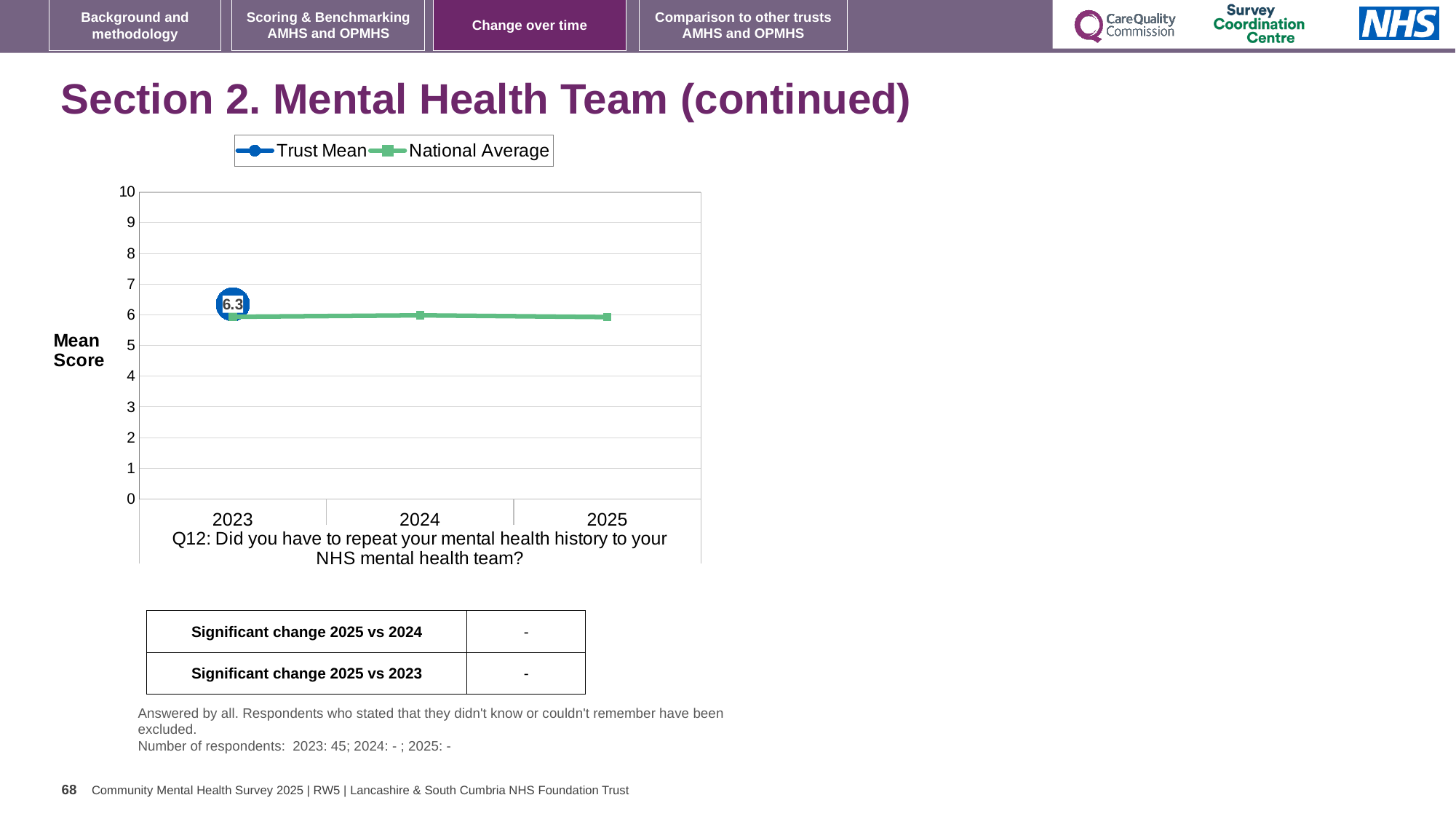
Which series is shown in green in the legend? National Average Which is larger in 2023, the Trust Mean or the National Average? Trust Mean Is the Trust Mean value for 2023 greater or less than 8? less Is the National Average value for 2024 greater or less than 5? greater How many series does the legend list? 2 What kind of chart is shown on the slide? line chart What is the label on the y axis? Mean Score What is the Trust Mean value for 2023? 6.3 Is the National Average value for 2025 greater or less than 7? less How many years are shown on the x axis? 3 What is the highest value shown on the y axis? 10 For which year is a Trust Mean data label shown? 2023